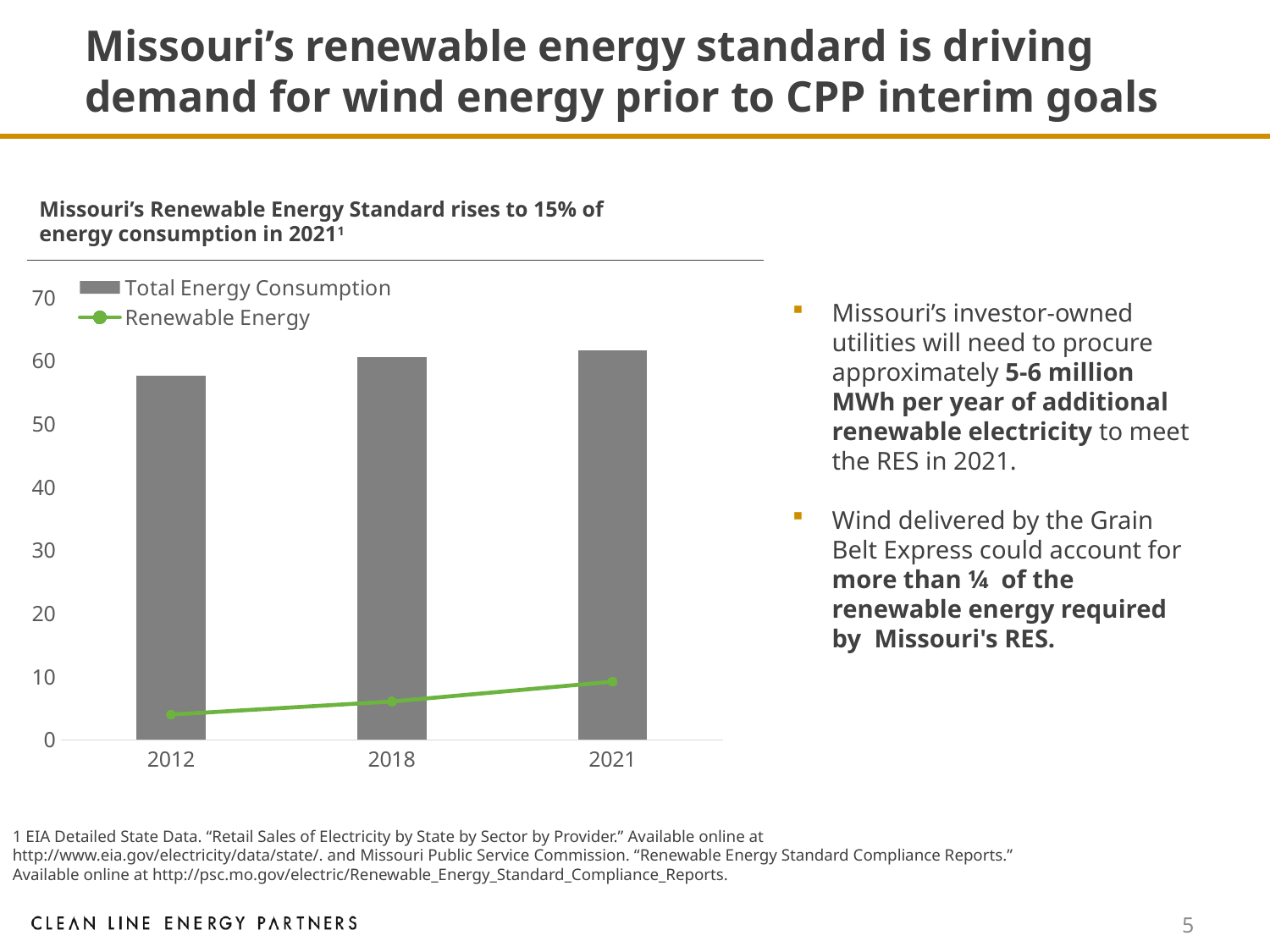
Which series is drawn as grey bars in the chart? Total Energy Consumption How many series does the chart's legend list? 2 Does the Renewable Energy line rise or fall from 2012 to 2021? Rises Is the Total Energy Consumption value for 2012 greater or less than 50? greater Which year has the lowest Total Energy Consumption bar? 2012 What kind of chart is shown on the slide? A bar chart with a line series overlaid Which series is drawn as a green line in the chart? Renewable Energy Do the Total Energy Consumption bars rise or fall from 2012 to 2021? Rise How many years are shown on the x axis of the chart? 3 Which year has the highest Renewable Energy value? 2021 Which is larger, Total Energy Consumption in 2012 or in 2021? 2021